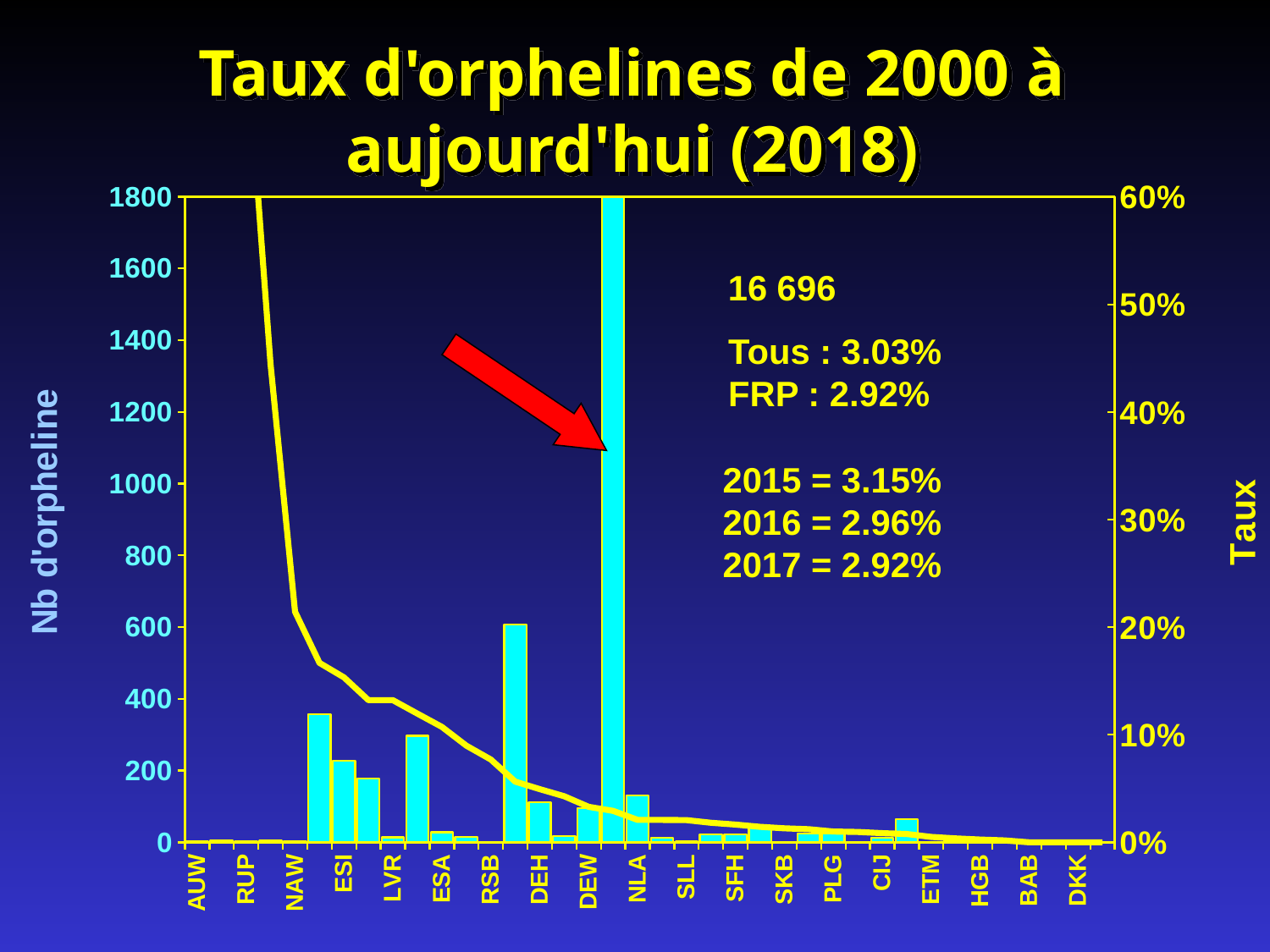
Is the bar for ESI greater or less than 200 on the left axis? greater Does the yellow line (Taux) rise or fall from left to right along the x axis? Fall Is the yellow line value (Taux) at RUP greater or less than 50%? greater Is the bar for NLA greater or less than 200 on the left axis? less Which has the taller bar, ESI or NLA? ESI What kind of chart is shown on the slide? A combined bar and line chart What is the label of the left vertical axis? Nb d'orpheline Among the labelled categories ESI, ESA and DEH, which has the tallest bar? ESI What is the title of the chart on the slide? Taux d'orphelines de 2000 à aujourd'hui (2018)